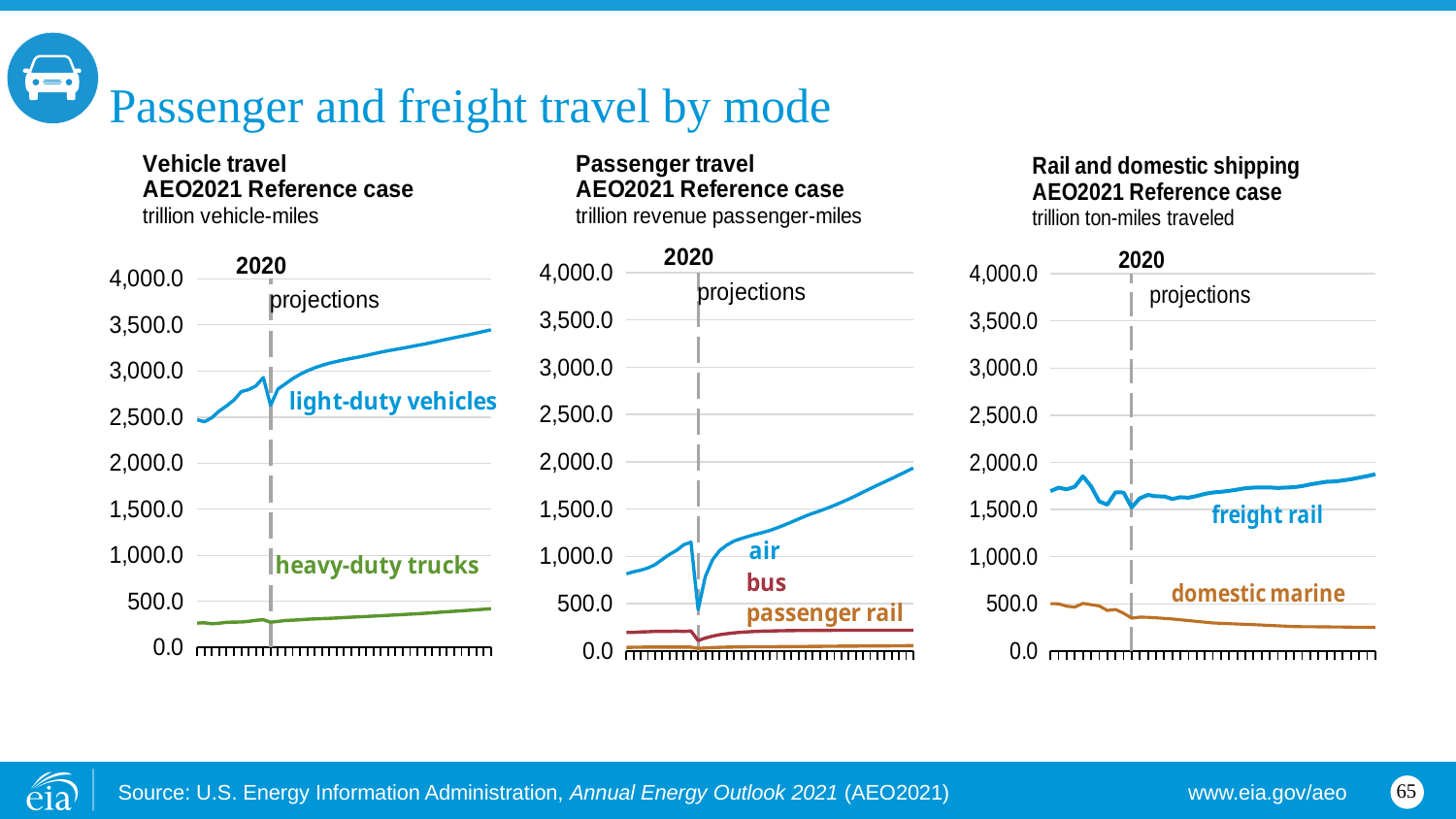
On the Passenger travel chart, which series is larger at the end of the projection period, air or bus? air On the Vehicle travel chart, is the value for light-duty vehicles at the end of the projection period greater or less than 3,000.0? greater How many series are plotted on the Rail and domestic shipping chart? 2 On the Rail and domestic shipping chart, does the domestic marine series rise or fall over the projection period? fall What unit is used on the Rail and domestic shipping chart? trillion ton-miles traveled On the Rail and domestic shipping chart, which series is larger, freight rail or domestic marine? freight rail What type of chart is the Vehicle travel chart? line chart On the Passenger travel chart, is the value for air at the end of the projection period greater or less than 1,500.0? greater How many series are plotted on the Passenger travel chart? 3 How many series are plotted on the Vehicle travel chart? 2 What year does the dashed vertical line mark on each chart? 2020 On the Vehicle travel chart, is the value for heavy-duty trucks at the end of the projection period greater or less than 500.0? less